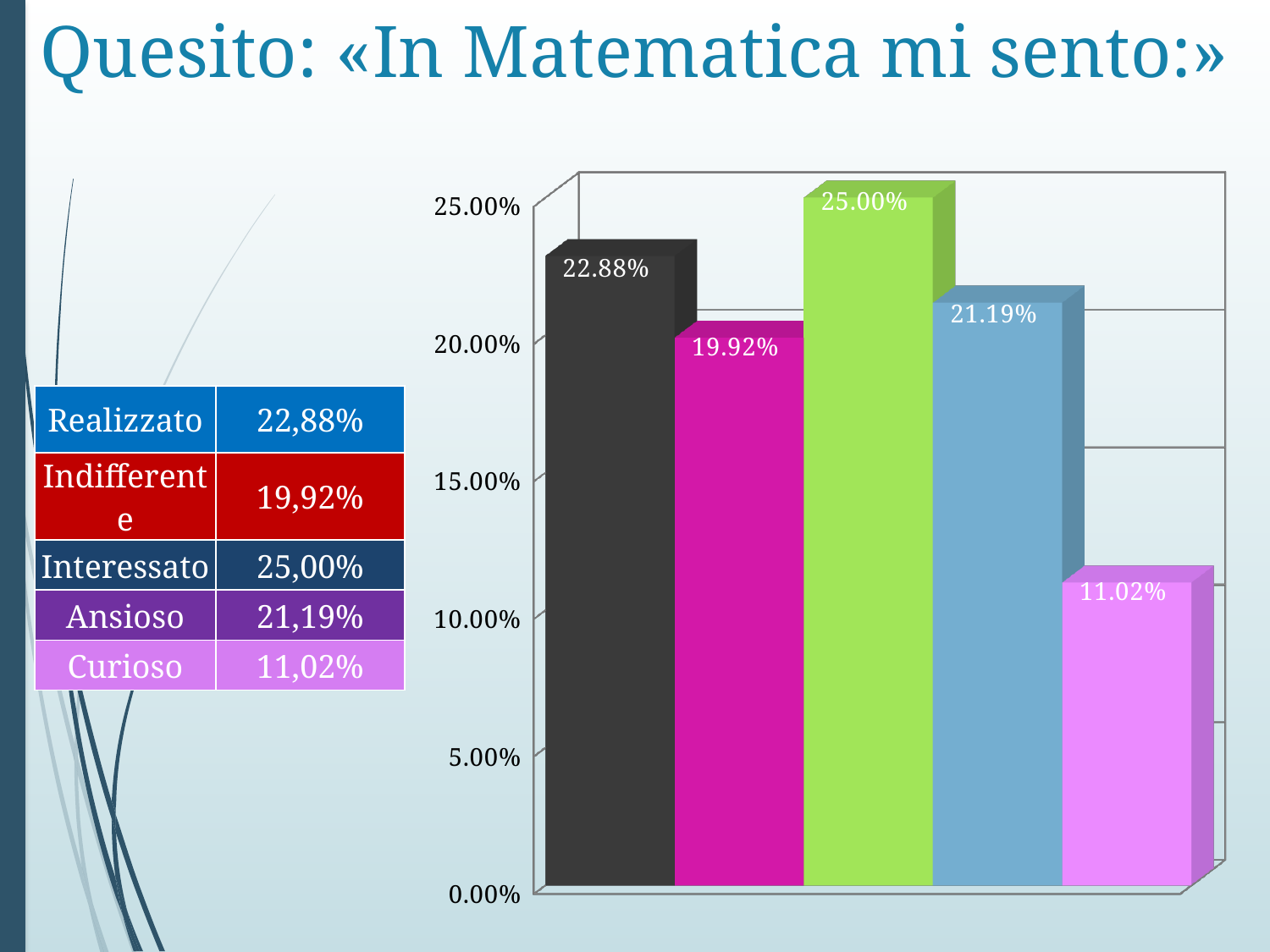
What value is shown on the first (dark grey) bar of the chart? 22.88% According to the table, what percentage corresponds to 'Ansioso'? 21,19% Is the value of the magenta bar greater or less than 20.00%? less What is the difference between the green bar (25.00%) and the magenta bar (19.92%)? 5.08% How many bars are plotted in the chart? 5 Which bar has the highest value in the chart? The green bar (25.00%) What type of chart is shown on the slide? Bar chart Which is larger, the dark grey bar or the blue bar? The dark grey bar (22.88%) Which bar has the lowest value in the chart? The light purple bar (11.02%) What is the title of the slide containing the chart? Quesito: «In Matematica mi sento:» What value is shown on the green bar of the chart? 25.00% What value is shown on the last (light purple) bar of the chart? 11.02%